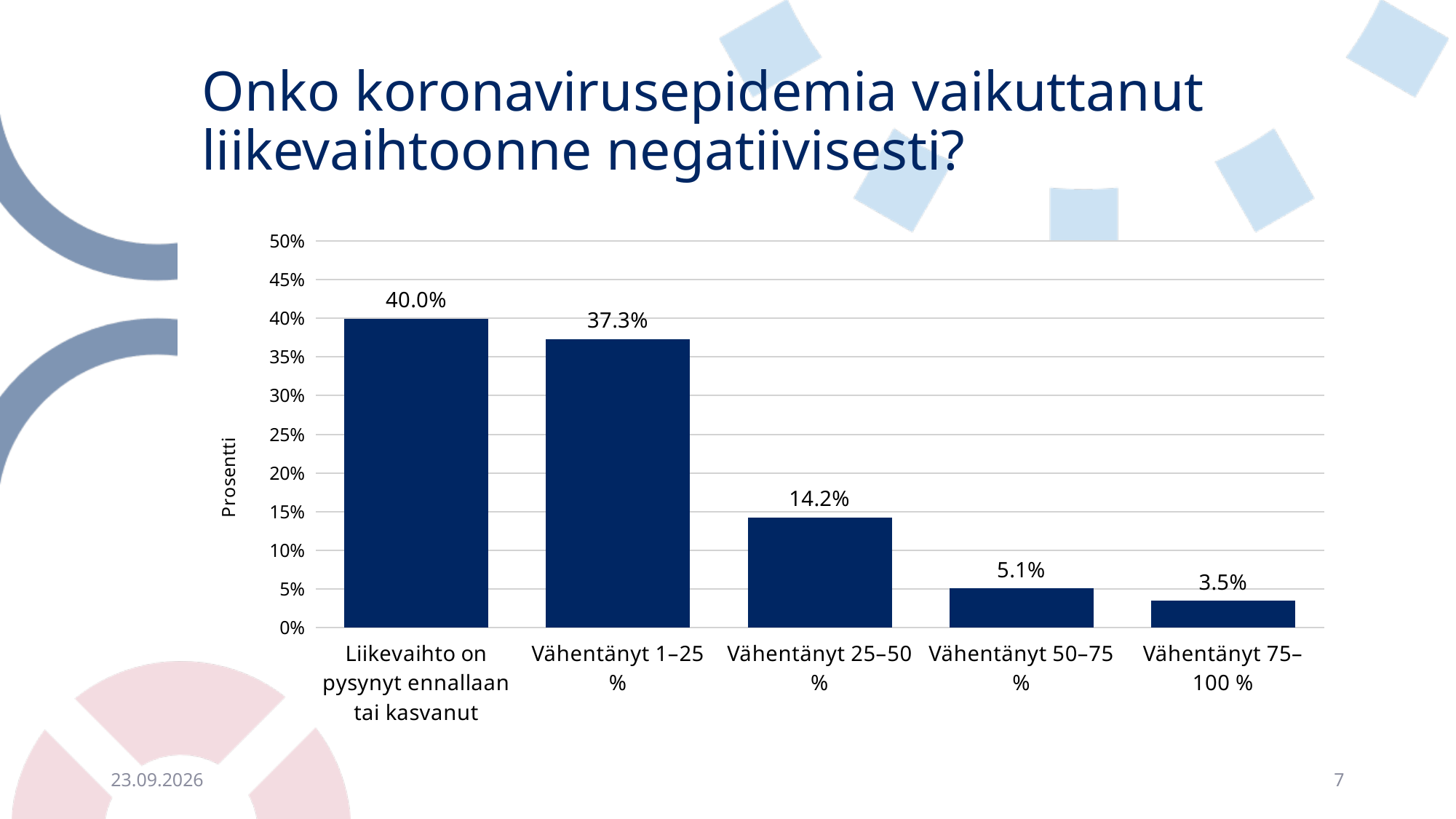
What is the label of the vertical axis? Prosentti What is the difference between the values for "Vähentänyt 1–25 %" and "Vähentänyt 25–50 %"? 23.1% Do the values rise or fall from left to right along the x axis? fall What is the value for "Liikevaihto on pysynyt ennallaan tai kasvanut"? 40.0% Which category has the highest value? Liikevaihto on pysynyt ennallaan tai kasvanut Which is larger, the value for "Vähentänyt 50–75 %" or "Vähentänyt 75–100 %"? Vähentänyt 50–75 % What kind of chart is shown on the slide? bar chart What is the value for "Vähentänyt 75–100 %"? 3.5% Is the value for "Vähentänyt 1–25 %" greater or less than 35%? greater How many categories are shown on the x axis? 5 Which category has the lowest value? Vähentänyt 75–100 % What is the value for "Vähentänyt 25–50 %"? 14.2%